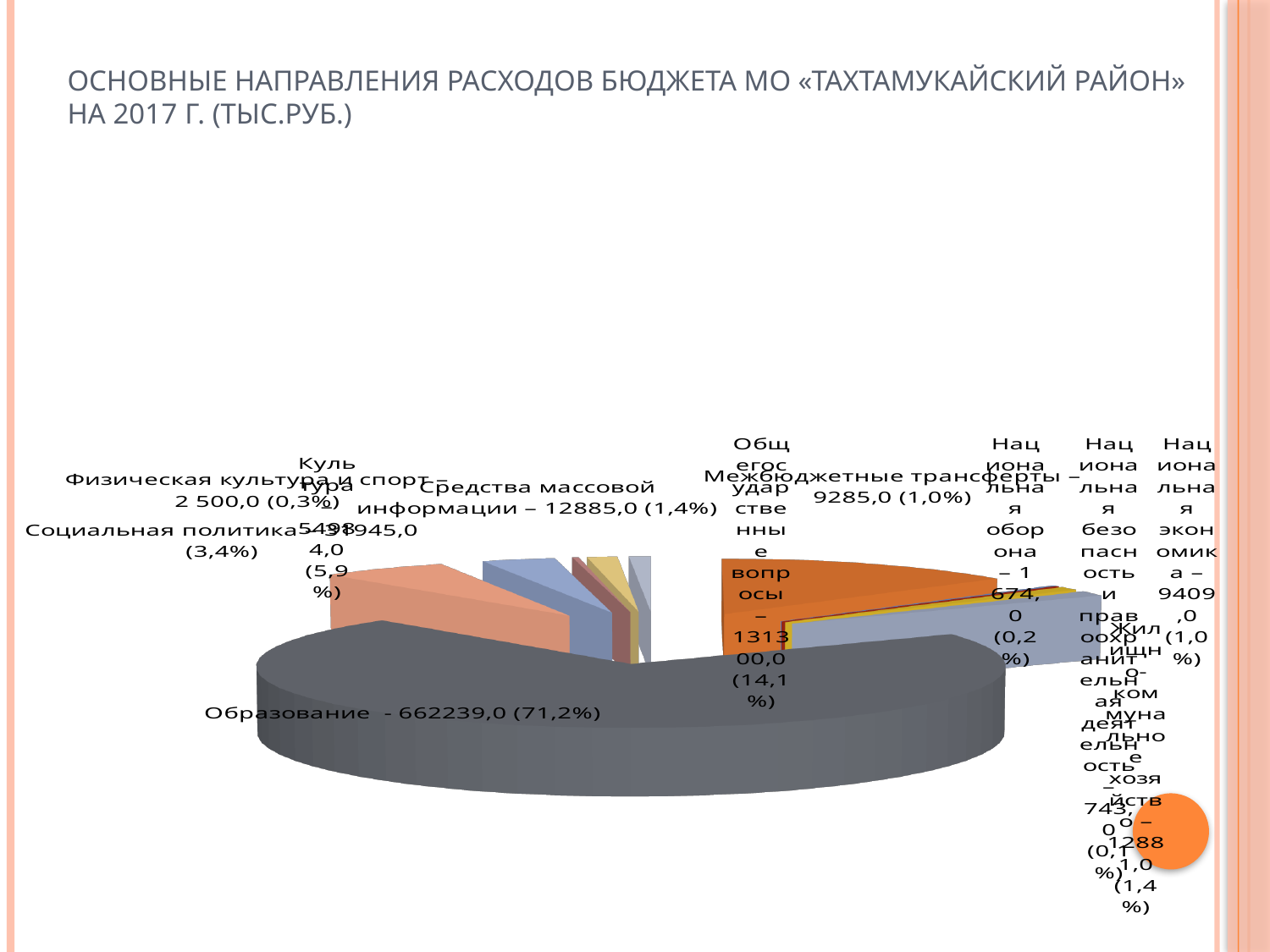
What is the value for Образование? 662239,0 What is the title of the chart? Основные направления расходов бюджета МО «Тахтамукайский район» на 2017 г. (тыс.руб.) What is the value for Средства массовой информации? 12885,0 What share of the pie does Общегосударственные вопросы take? 14,1% What share of the pie does Социальная политика take? 3,4% What share of the pie does Образование take? 71,2% What is the value for Межбюджетные трансферты? 9285,0 Which category has the largest share of the budget expenditures? Образование What is the value for Общегосударственные вопросы? 131300,0 What kind of chart is shown on the slide? pie chart What is the difference between the values for Образование and Общегосударственные вопросы? 530939,0